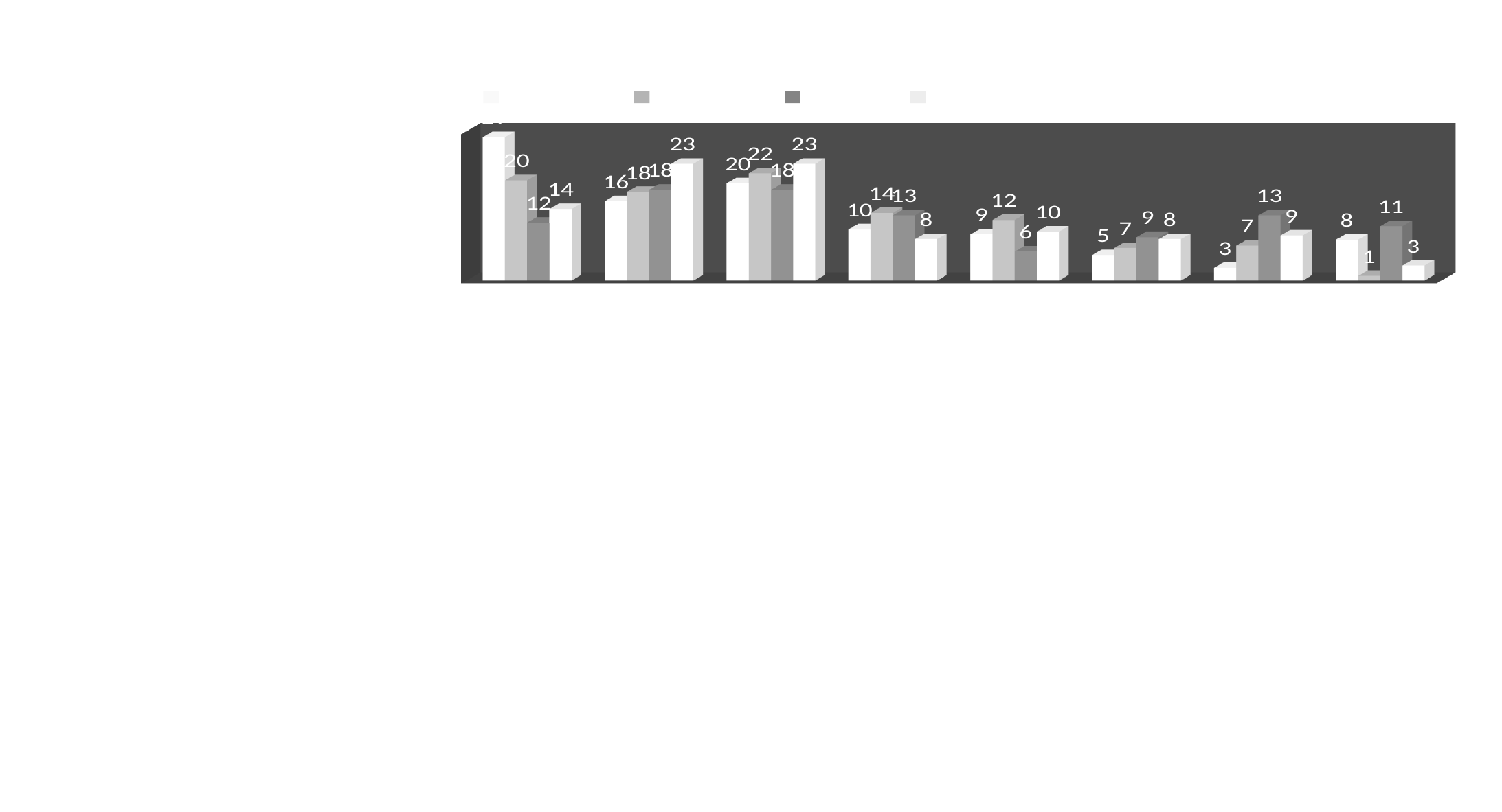
How many groups of bars are plotted on the chart? 8 What kind of chart is shown on the slide? bar chart What is the smallest value labelled on any bar in the chart? 1 How many bars are there in each group on the chart? 4 Is the chart drawn with a 3D effect? yes How many series does the legend list? 4